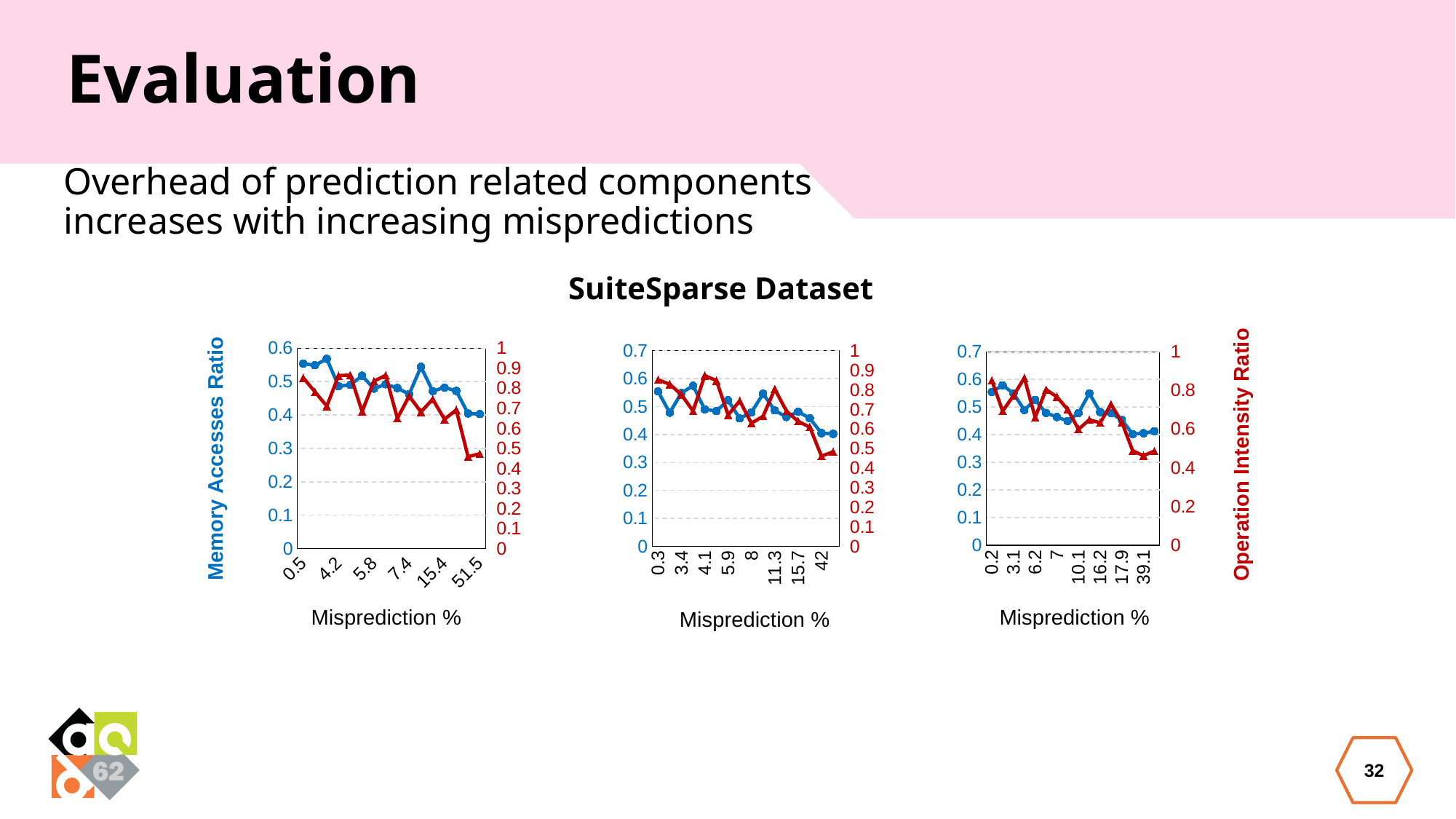
In the middle chart, does the red Operation Intensity Ratio line generally rise or fall as Misprediction % increases? fall In the right chart, does the blue Memory Accesses Ratio line generally rise or fall as Misprediction % increases? fall What type of chart is the left chart under the SuiteSparse Dataset heading? line chart What is the title shown above the three charts? SuiteSparse Dataset In the left chart, is the blue Memory Accesses Ratio value at 0.5 Misprediction % greater or less than 0.5? greater In the middle chart, is the blue Memory Accesses Ratio value at 42 Misprediction % greater or less than 0.5? less What is the label of the x axis on the middle chart? Misprediction % In the left chart, is the red Operation Intensity Ratio value at 51.5 Misprediction % greater or less than 0.6? less In the left chart, how many data series are plotted? 2 In the left chart, does the blue Memory Accesses Ratio line generally rise or fall as Misprediction % increases? fall